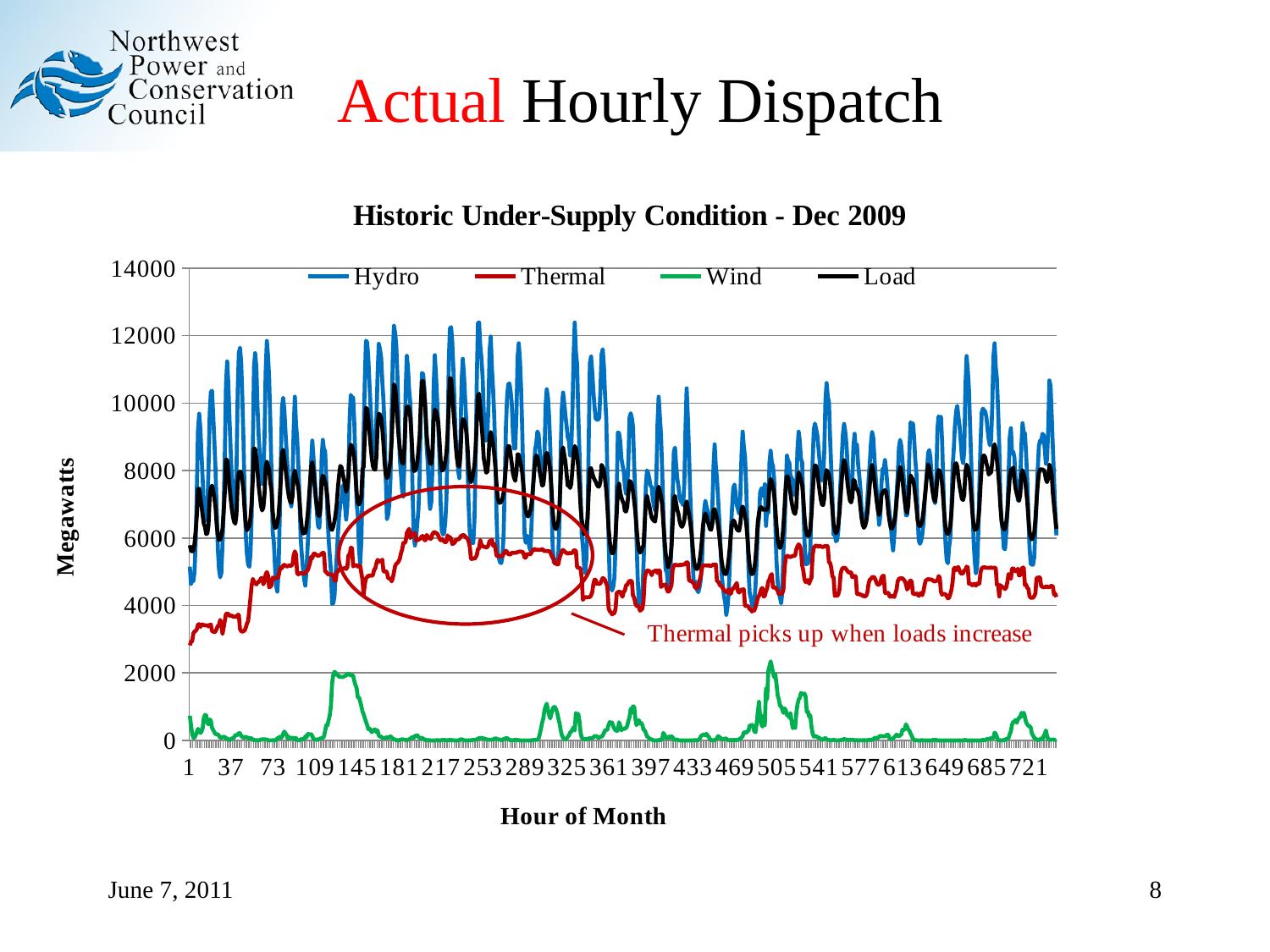
How many series does the legend list? 4 Which series reaches the highest peak values on the chart? Hydro Is the Thermal value at hour 1 greater or less than 4000? less At hour 1, which is larger, the Load value or the Wind value? Load Which series stays lowest across the whole month? Wind Is the Wind value at hour 1 greater or less than 2000? less What is the title of the chart? Historic Under-Supply Condition - Dec 2009 Does the Thermal series rise or fall between hour 1 and hour 109? rise Is the highest Hydro value on the chart greater or less than 12000? greater What kind of chart is shown on the slide? line chart What is the label of the vertical axis? Megawatts